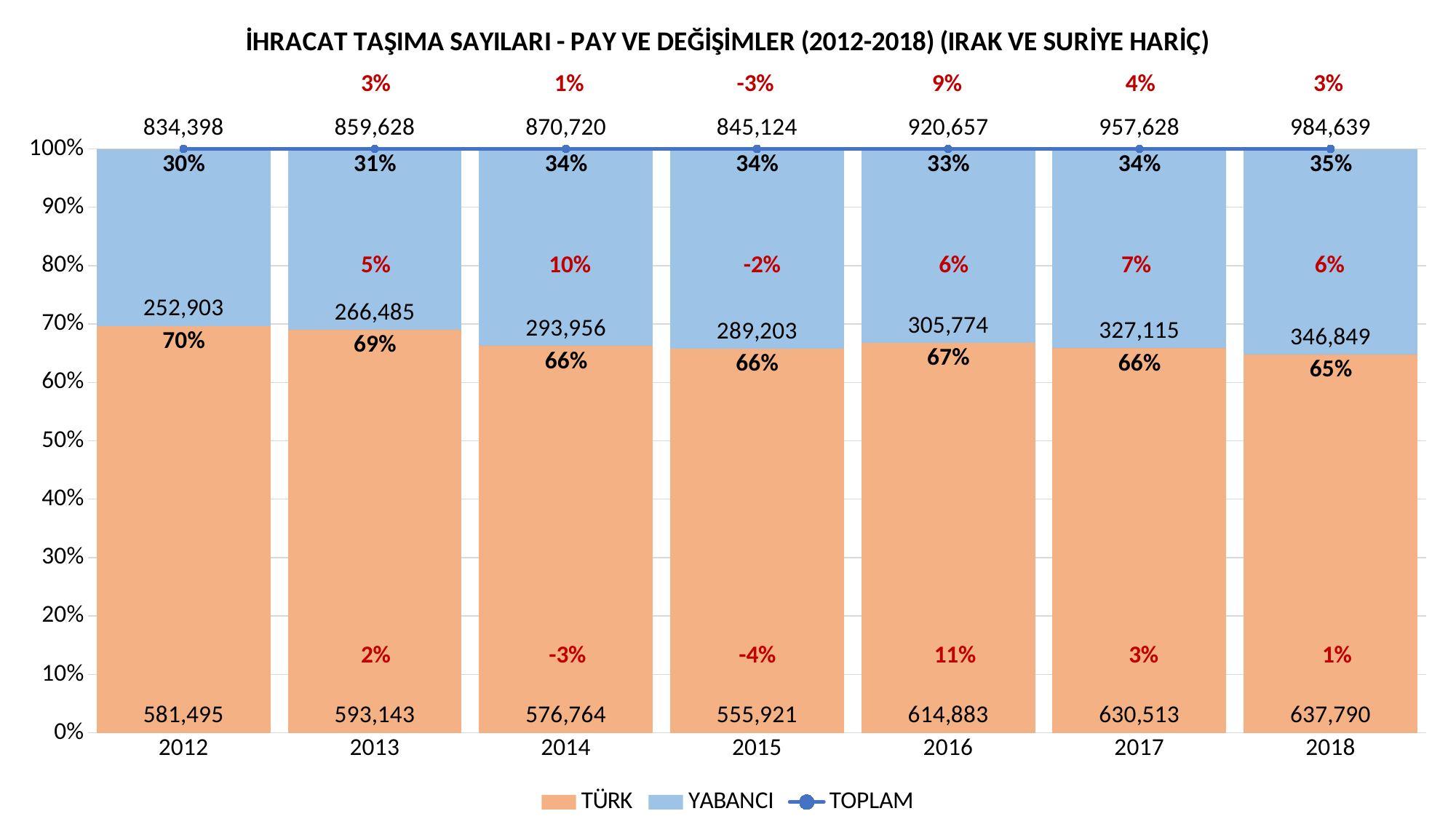
Which year has the lowest TÜRK value? 2015 What is the difference between the TOPLAM value in 2018 and in 2012? 150,241 What is the YABANCI value for 2018? 346,849 Does the YABANCI share rise or fall from 2012 to 2018? Rise Which year has the larger TÜRK value, 2013 or 2014? 2013 Which year has the highest TOPLAM value? 2018 How many series does the legend list? 3 How many years are shown on the x axis? 7 What is the TOPLAM value for 2016? 920,657 What is the TÜRK value for 2012? 581,495 What percentage share does TÜRK have in 2018? 65% What kind of chart is this? Stacked bar chart with a line